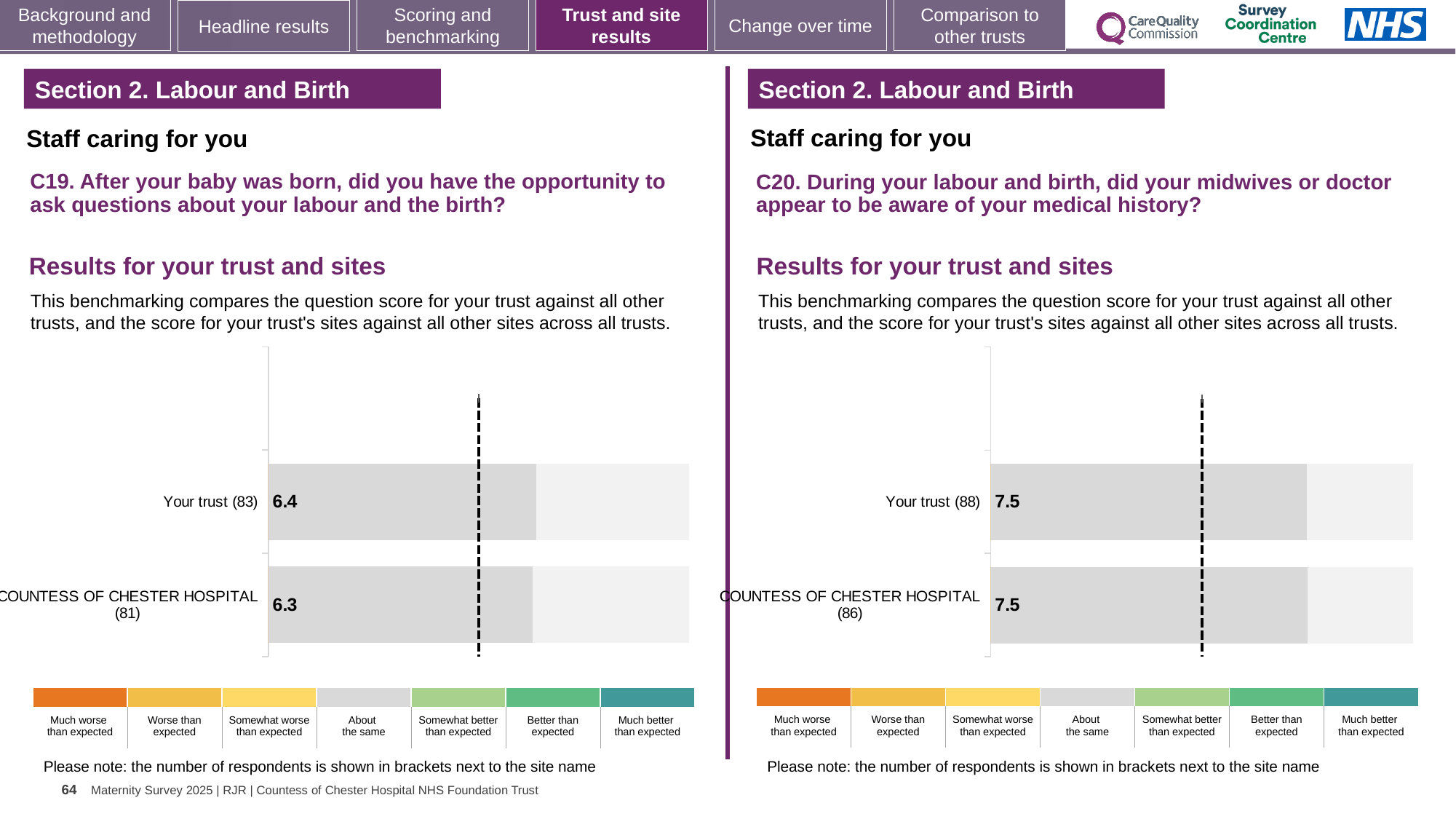
On the left chart (C19), which has the higher score, Your trust or COUNTESS OF CHESTER HOSPITAL? Your trust On the left chart (C19), what is the score for COUNTESS OF CHESTER HOSPITAL? 6.3 How many bars are plotted on the left chart (C19)? 2 What type of chart is used on the right side of the slide (C20)? Bar chart On the left chart (C19), what is the score for Your trust? 6.4 On the right chart (C20), what is the score for Your trust? 7.5 On the right chart (C20), how many respondents are shown in brackets for COUNTESS OF CHESTER HOSPITAL? 86 On the left chart (C19), what is the difference between the score for Your trust and the score for COUNTESS OF CHESTER HOSPITAL? 0.1 On the right chart (C20), what is the difference between the score for Your trust and the score for COUNTESS OF CHESTER HOSPITAL? 0 On the left chart (C19), how many respondents are shown in brackets for Your trust? 83 On the right chart (C20), what is the score for COUNTESS OF CHESTER HOSPITAL? 7.5 How many bars are plotted on the right chart (C20)? 2